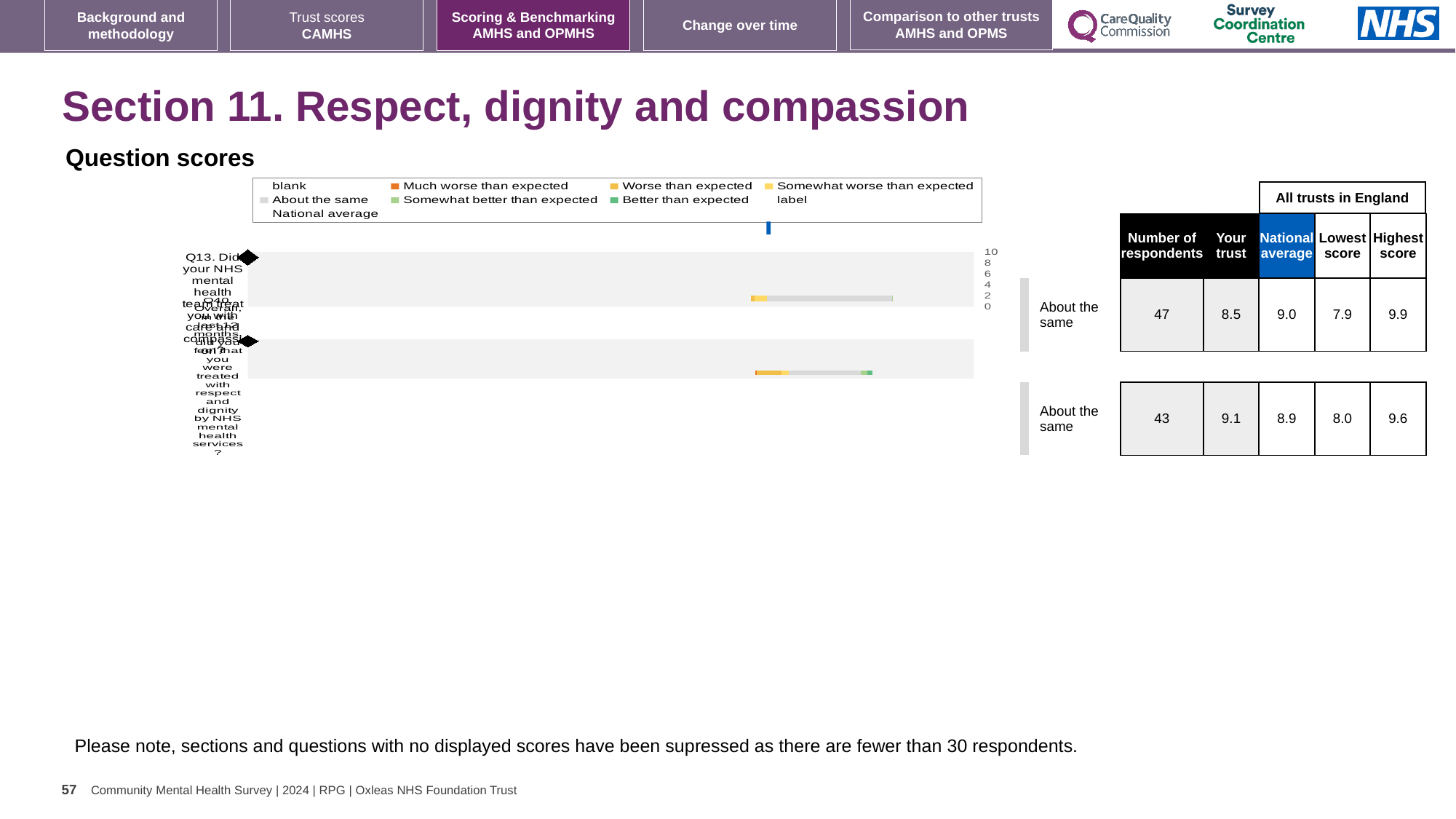
For the bottom row of the table, which is larger: the 'Your trust' score or the national average? Your trust In the table next to the chart, what is the 'Your trust' score for the top row? 8.5 In the table next to the chart, what is the highest score for the bottom row? 9.6 What benchmark category is shown beside both bars in the chart? About the same In the table next to the chart, what is the lowest score for the bottom row? 8.0 What kind of chart is shown under 'Question scores'? bar chart What is the difference between the highest score and the lowest score in the top row of the table? 2.0 In the table next to the chart, what is the 'Your trust' score for the bottom row? 9.1 What colour represents 'Better than expected' in the chart legend? green In the table next to the chart, what is the number of respondents for the top row? 47 How many questions (bars) are plotted in the Question scores chart? 2 In the table next to the chart, what is the national average for the top row? 9.0